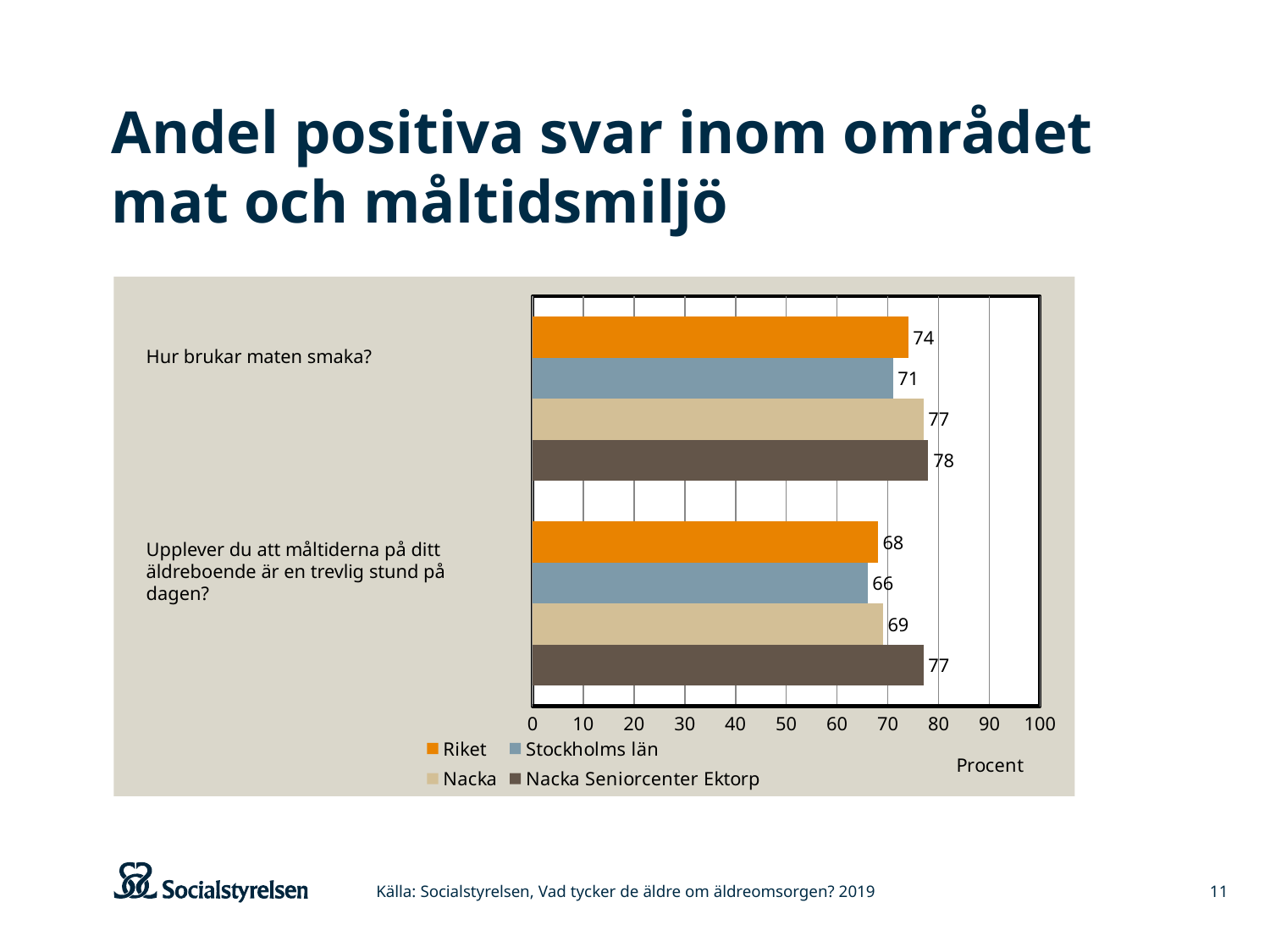
Which is larger for "Hur brukar maten smaka?": Riket or Nacka? Nacka Which series has the highest value for "Upplever du att måltiderna på ditt äldreboende är en trevlig stund på dagen?"? Nacka Seniorcenter Ektorp What is the difference between Nacka Seniorcenter Ektorp and Nacka for "Upplever du att måltiderna på ditt äldreboende är en trevlig stund på dagen?"? 8 What kind of chart is shown on the slide? bar chart What is the value for Riket for "Hur brukar maten smaka?"? 74 Is the value for Riket for "Upplever du att måltiderna på ditt äldreboende är en trevlig stund på dagen?" greater or less than 70? less What is the value for Stockholms län for "Upplever du att måltiderna på ditt äldreboende är en trevlig stund på dagen?"? 66 How many questions (categories) are shown on the chart? 2 Which series has the lowest value for "Hur brukar maten smaka?"? Stockholms län What is the label on the horizontal axis of the chart? Procent What is the value for Nacka Seniorcenter Ektorp for "Hur brukar maten smaka?"? 78 How many series does the legend list? 4